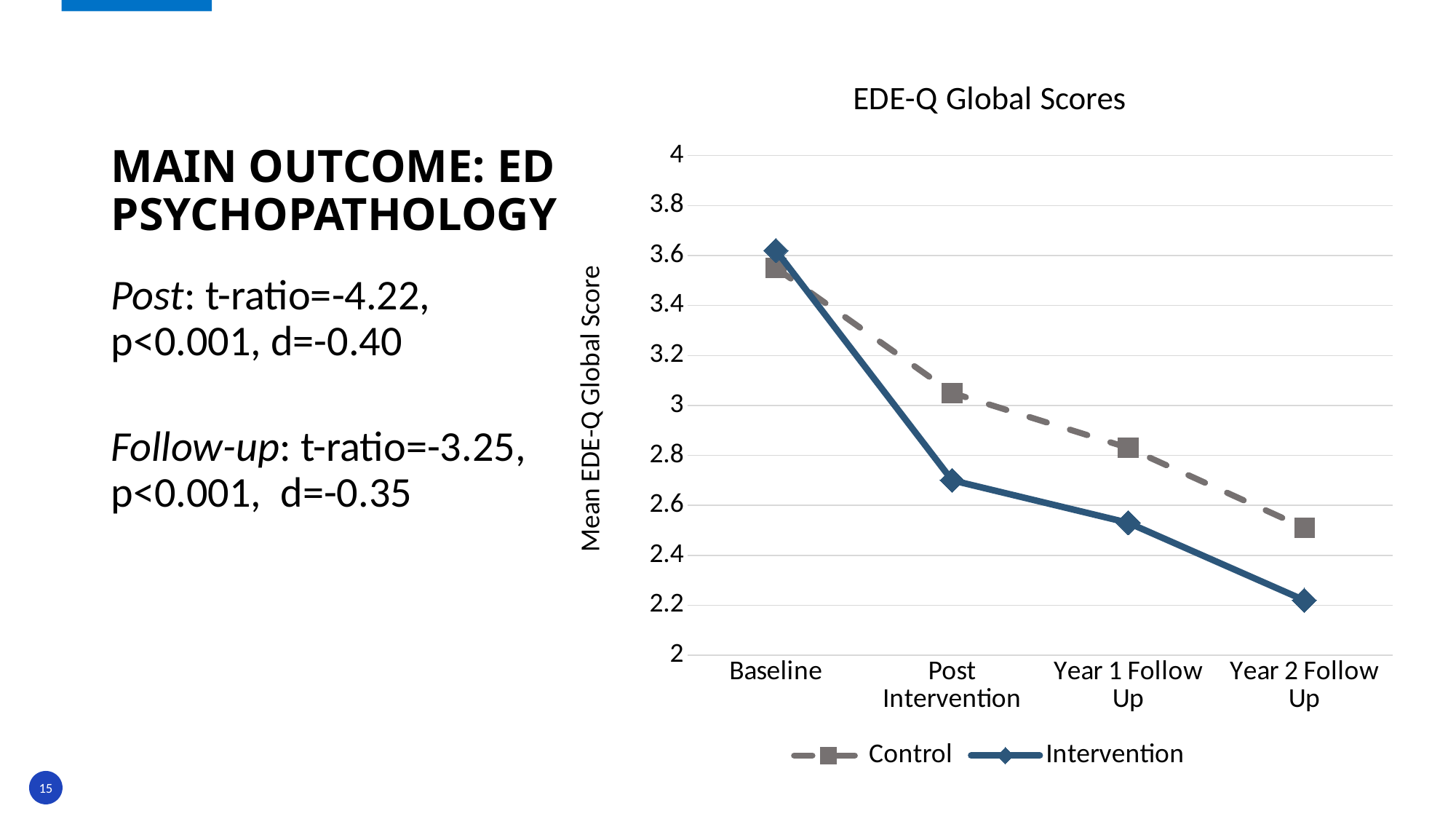
At which time point is the Intervention series lowest? Year 2 Follow Up At Post Intervention, which series has the higher value, Control or Intervention? Control How many time points are plotted along the x axis? 4 At Year 2 Follow Up, which series has the lower value, Control or Intervention? Intervention What kind of chart is shown on the slide? line chart Is the Intervention value at Post Intervention greater or less than 3? less Is the Control value at Baseline greater or less than 3.4? greater What is the title of the chart? EDE-Q Global Scores How many series does the legend list? 2 What is the label on the y axis? Mean EDE-Q Global Score Do the Intervention values rise or fall from Baseline to Year 2 Follow Up? fall Is the Intervention value at Year 2 Follow Up greater or less than 2.4? less